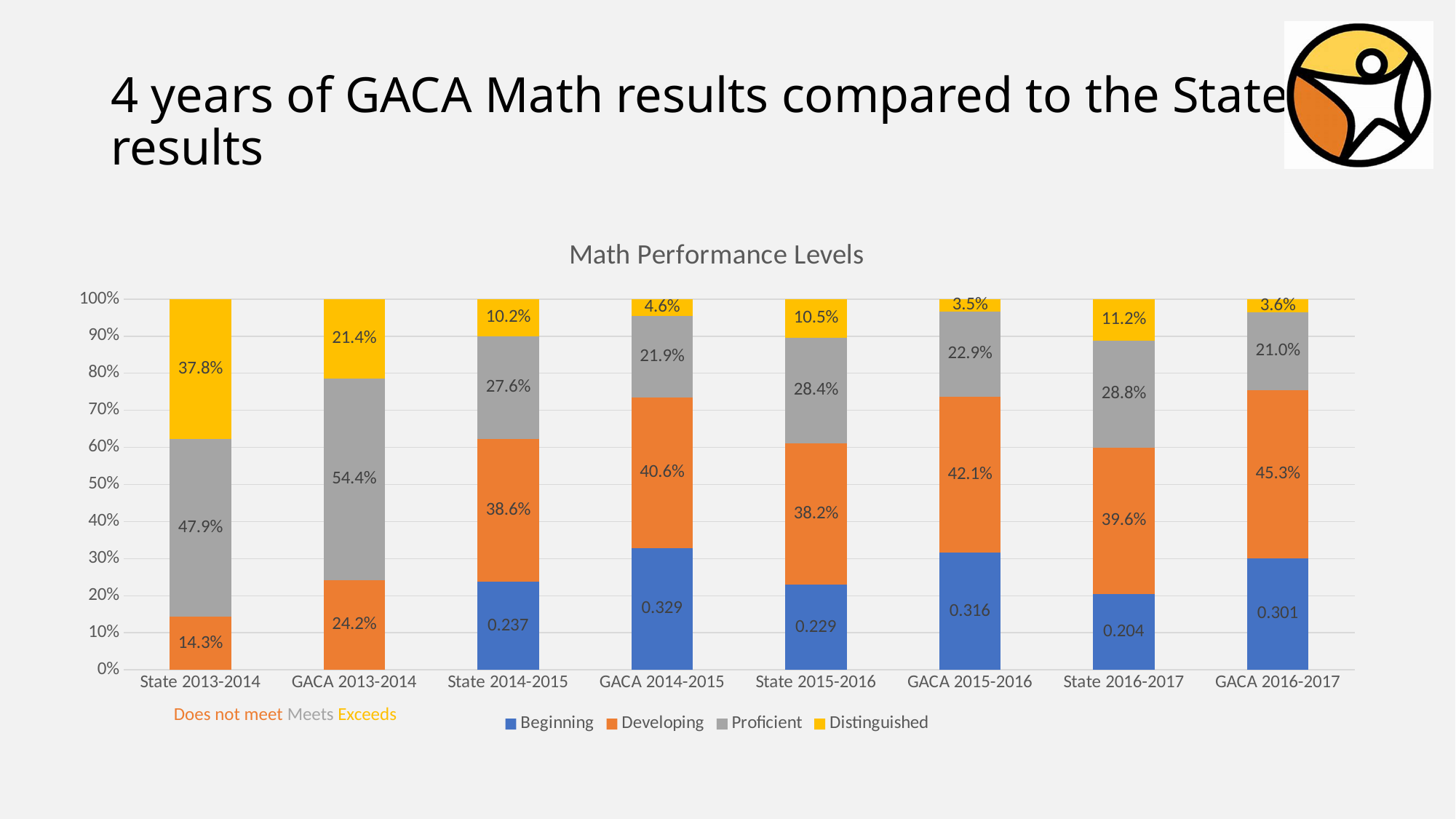
Which category has the highest Distinguished value? State 2013-2014 What is the Distinguished value for State 2016-2017? 11.2% Which has the larger Proficient value, State 2013-2014 or GACA 2013-2014? GACA 2013-2014 How many categories are shown on the x axis? 8 How many series does the legend list? 4 What is the difference between the Developing values for GACA 2016-2017 and State 2016-2017? 5.7 percentage points Which category has the lowest Beginning value among those with a Beginning label? State 2016-2017 Does the Developing value for GACA rise or fall from 2013-2014 to 2016-2017? Rise What is the Developing value for State 2013-2014? 14.3% What kind of chart is shown? Stacked bar chart What is the Proficient value for GACA 2013-2014? 54.4% What is the Beginning value for GACA 2014-2015? 0.329